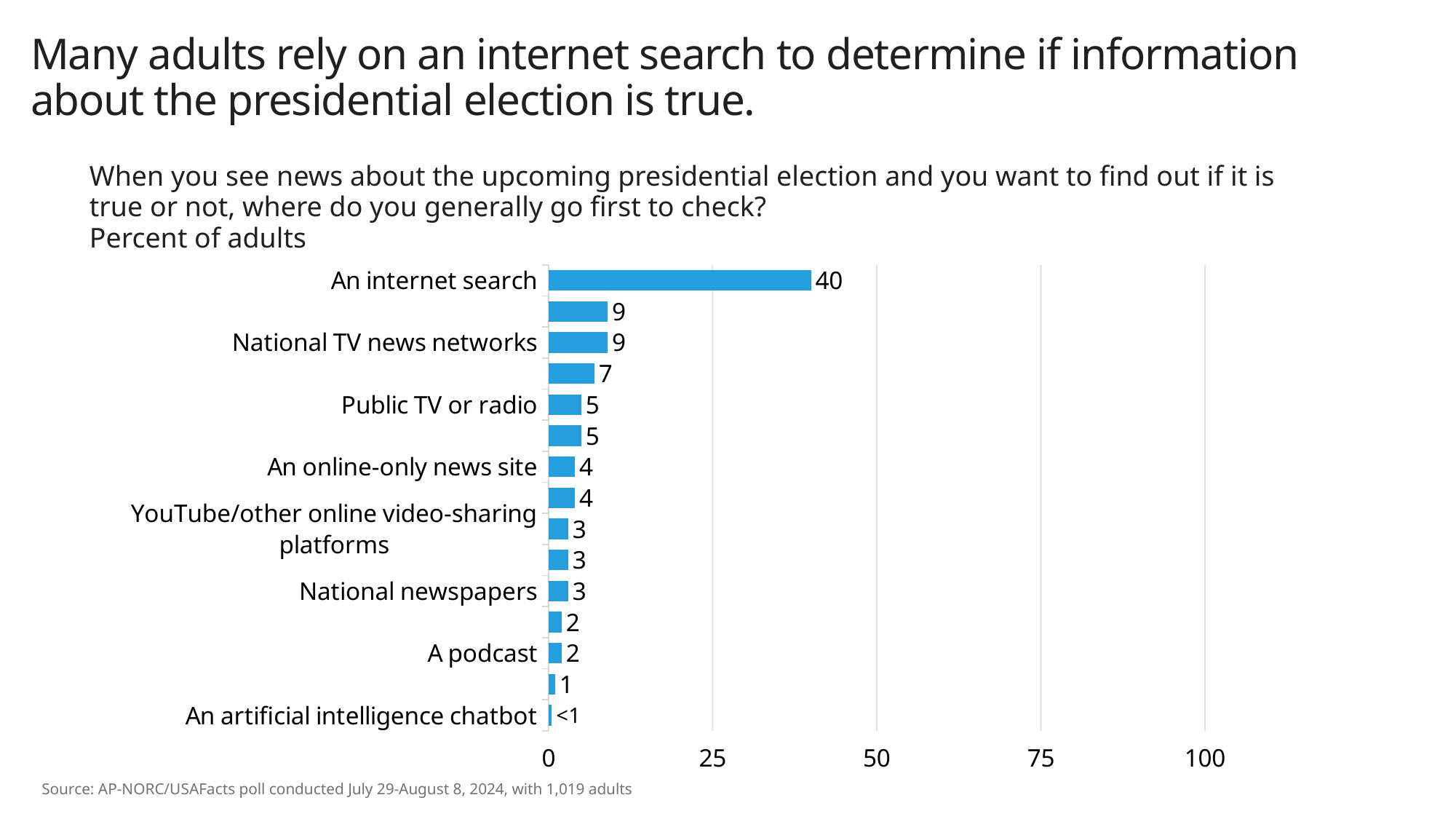
What is the value for A podcast? 2 What percent of adults go first to an internet search to check election news? 40 What is the value for National TV news networks? 9 Which category has the highest value? An internet search Which labeled category has the lowest value? An artificial intelligence chatbot What is the value shown for An artificial intelligence chatbot? <1 Is the value for An internet search greater or less than 25? greater What is the difference between the values for An internet search and National TV news networks? 31 What is the value for Public TV or radio? 5 What kind of chart is shown on the slide? Bar chart What is the value for An online-only news site? 4 Which is larger, the value for Public TV or radio or the value for A podcast? Public TV or radio